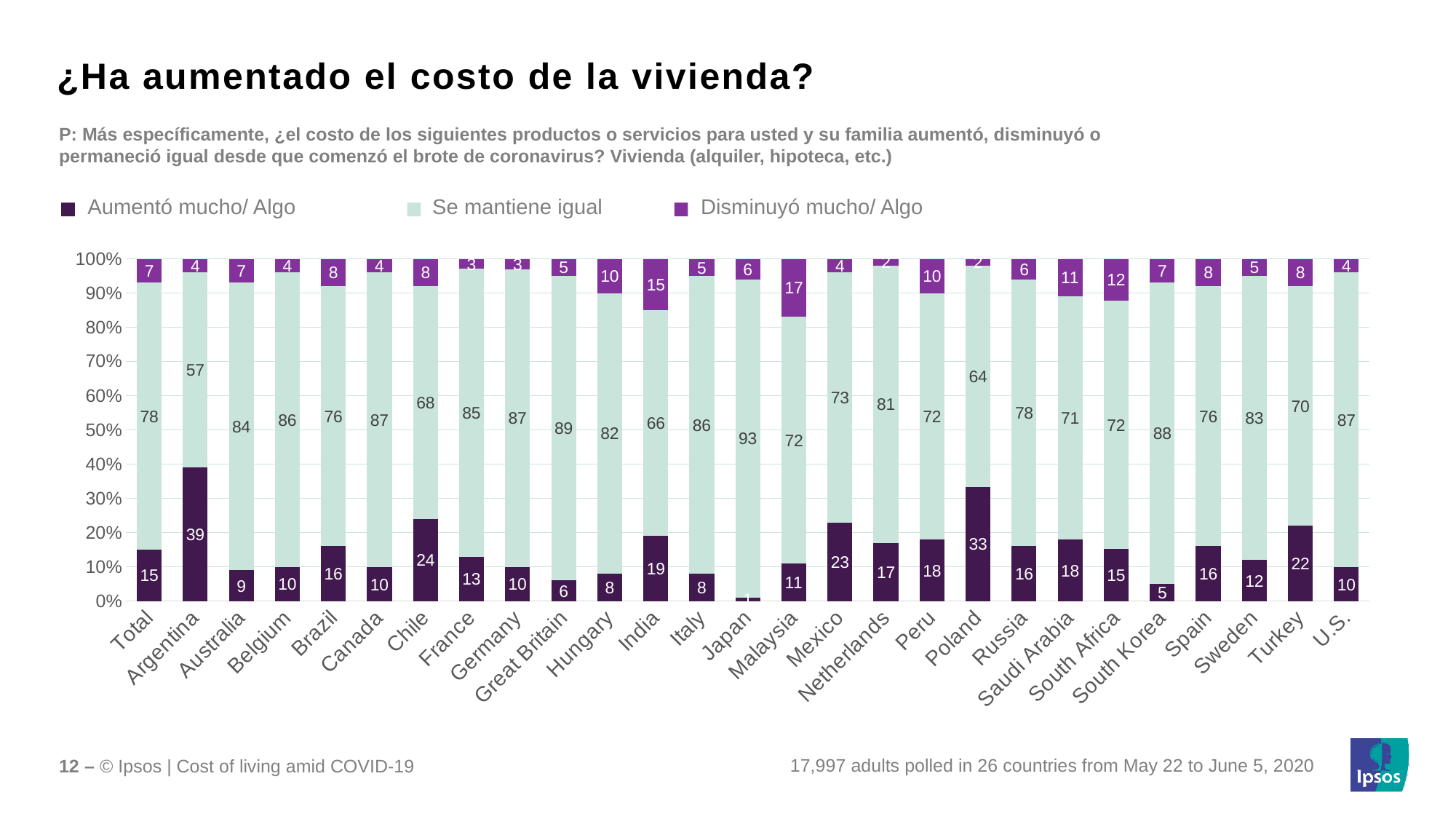
How many categories are shown on the x axis? 27 How many series does the legend list? 3 What is the value of 'Disminuyó mucho/ Algo' for Malaysia? 17 Which country has the highest value for 'Aumentó mucho/ Algo'? Argentina Which category has the highest value for 'Disminuyó mucho/ Algo'? Malaysia What is the value of 'Aumentó mucho/ Algo' for Argentina? 39 What is the value of 'Aumentó mucho/ Algo' for Total? 15 What type of chart is shown on the slide? stacked bar chart What is the value of 'Se mantiene igual' for Japan? 93 Which is larger, the 'Aumentó mucho/ Algo' value for Mexico or for Turkey? Mexico What is the difference between the 'Aumentó mucho/ Algo' values for Poland and Chile? 9 Which legend entry is shown in the light green colour? Se mantiene igual